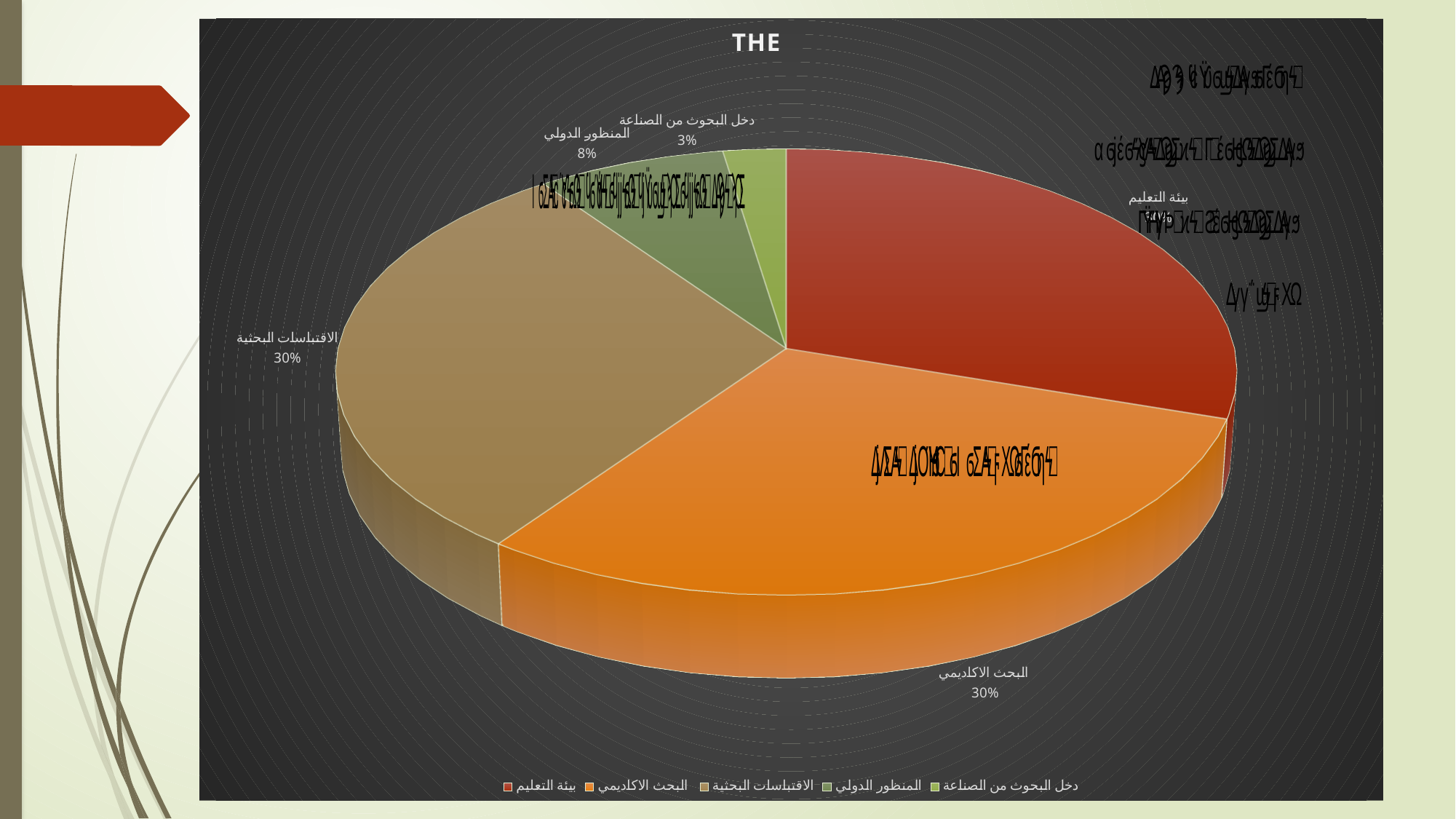
What percentage is shown for البحث الاكاديمي? 30% What colour is the slice for البحث الاكاديمي? orange How many entries does the legend list? 5 What percentage is shown for الاقتباسات البحثية? 30% What kind of chart is shown on the slide? pie chart What percentage is shown for المنظور الدولي? 8% Which slice has the smallest share of the pie? دخل البحوث من الصناعة What is the title of the chart? THE What percentage is shown for دخل البحوث من الصناعة? 3% What is the difference between the shares of المنظور الدولي and دخل البحوث من الصناعة? 5% Which is larger, المنظور الدولي or دخل البحوث من الصناعة? المنظور الدولي How many slices does the pie chart have? 5